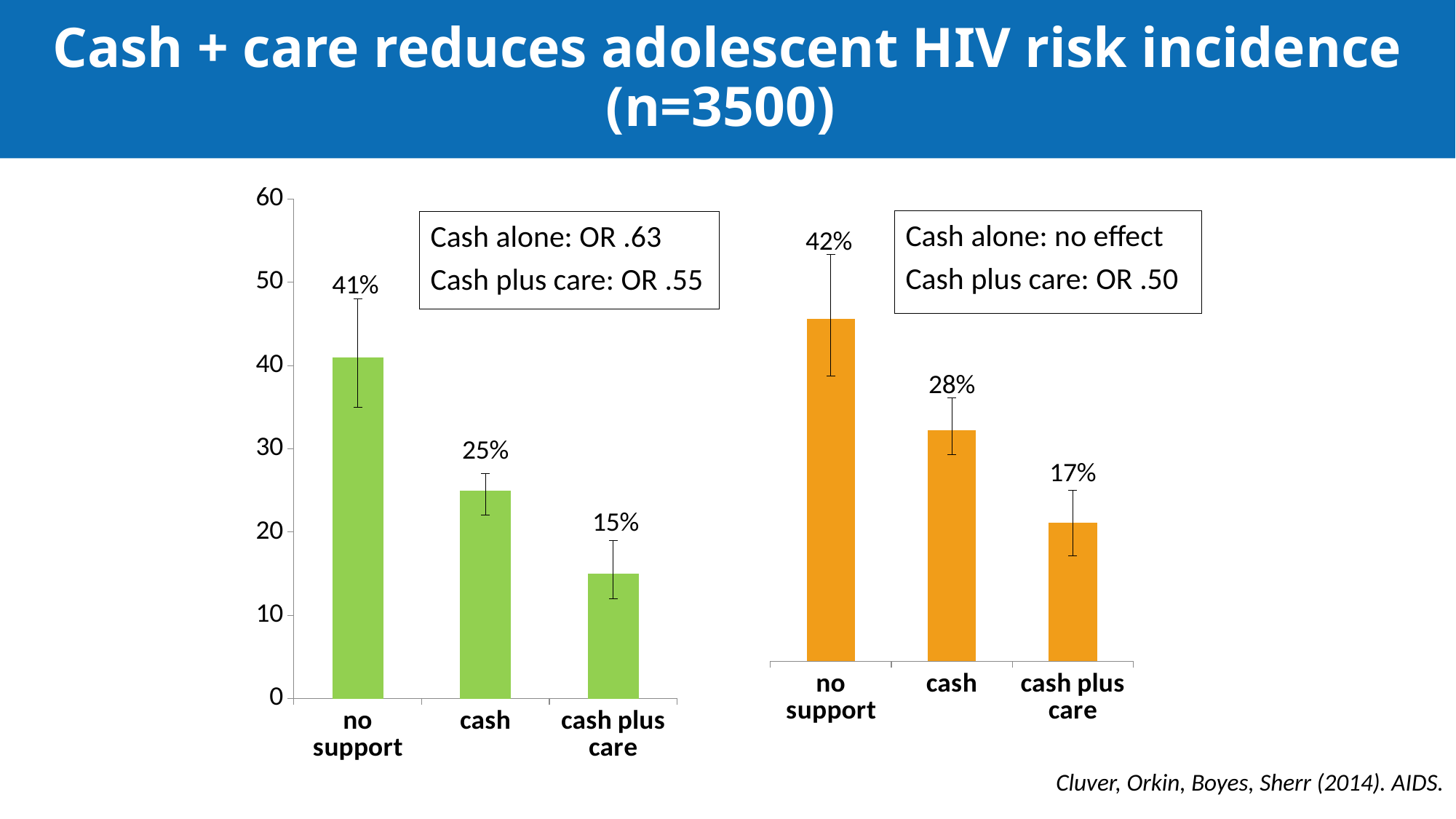
What type of chart is the right (orange) chart? bar chart In the left (green) chart, what is the value for 'no support'? 41% In the left (green) chart, what is the difference between the 'no support' value and the 'cash plus care' value? 26% In the right (orange) chart, what is the value for 'cash plus care'? 17% Which is larger: the 'cash' value in the left (green) chart or the 'cash' value in the right (orange) chart? the right (orange) chart In the left (green) chart, what is the value for 'cash plus care'? 15% In the left (green) chart, which category has the lowest value? cash plus care In the right (orange) chart, what is the difference between the 'cash' value and the 'cash plus care' value? 11% In the left (green) chart, do the values rise or fall from 'no support' to 'cash plus care'? fall How many categories are shown in the left (green) chart? 3 In the right (orange) chart, which category has the highest value? no support In the right (orange) chart, what is the value for 'cash'? 28%